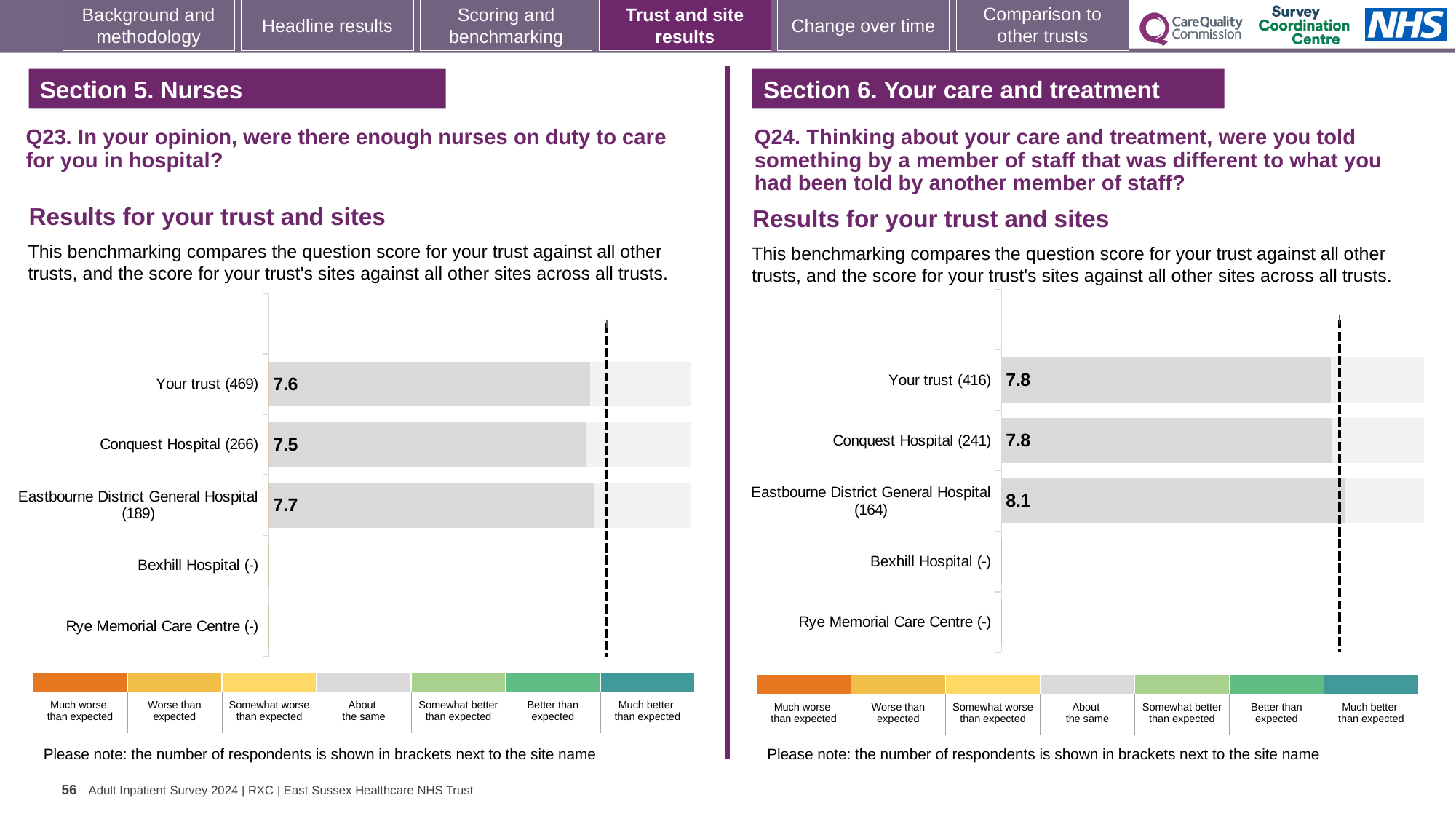
On the Q23 chart (left), what is the score for Conquest Hospital (266)? 7.5 On the Q23 chart (left), what is the difference between the scores for Eastbourne District General Hospital (189) and Conquest Hospital (266)? 0.2 On the Q24 chart (right), how many sites or trusts have a score shown as a bar? 3 On the Q24 chart (right), what is the difference between the scores for Eastbourne District General Hospital (164) and Your trust (416)? 0.3 What kind of chart is used on the Q23 chart (left)? Bar chart On the Q24 chart (right), which site or trust has the highest score? Eastbourne District General Hospital (164) On the Q24 chart (right), what is the score for Your trust (416)? 7.8 On the Q24 chart (right), what is the score for Eastbourne District General Hospital (164)? 8.1 On the Q23 chart (left), how many categories are listed on the vertical axis? 5 On the Q23 chart (left), which site or trust has the lowest score shown? Conquest Hospital (266) On the Q23 chart (left), what is the score for Your trust (469)? 7.6 On the Q23 chart (left), which site or trust has the highest score? Eastbourne District General Hospital (189)